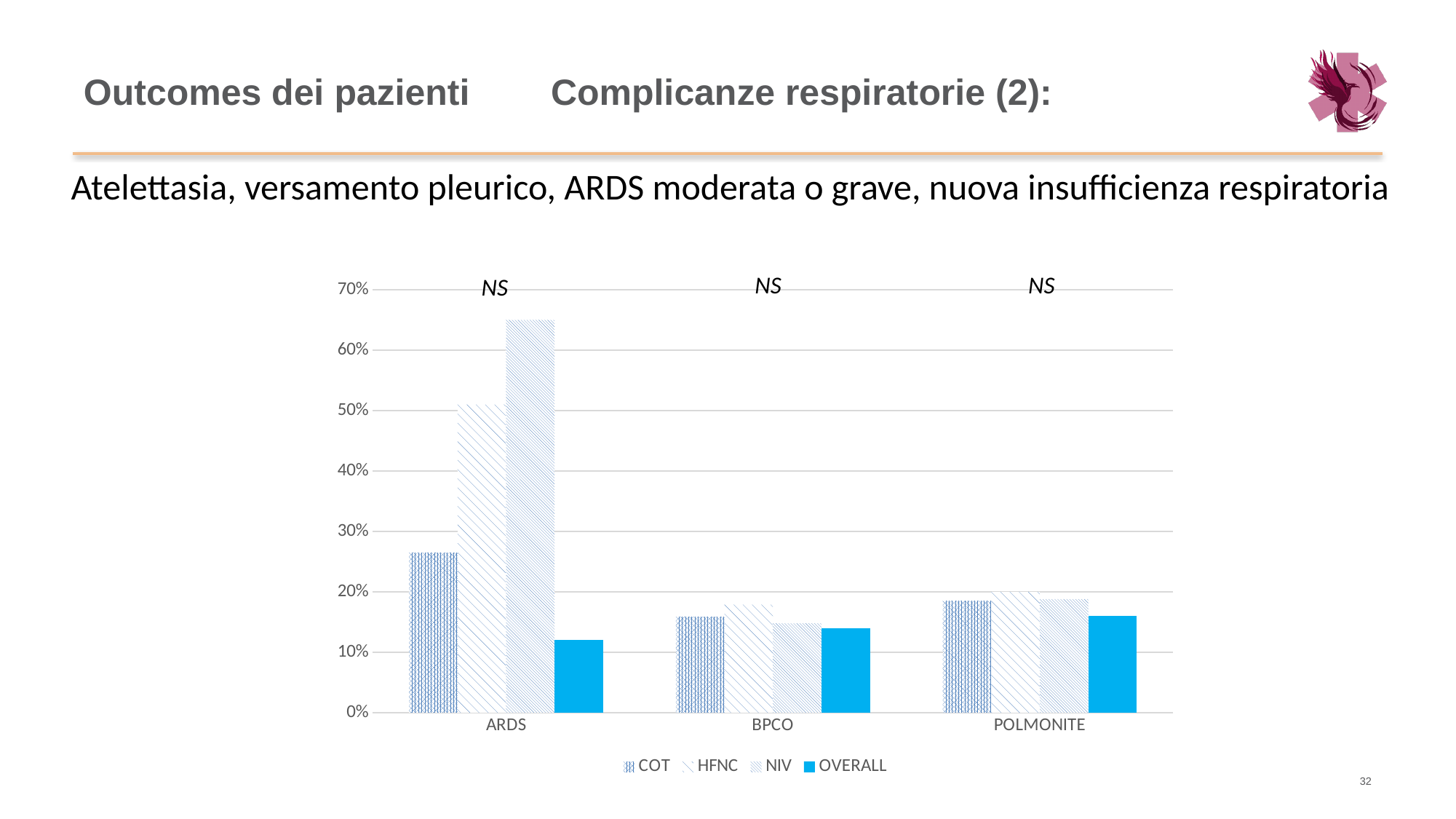
How many categories are shown on the x axis of the chart? 3 Which series has the highest value in the ARDS category? NIV Which category has the highest NIV value? ARDS What kind of chart is shown on the slide? bar chart Is the HFNC value for ARDS greater or less than 40%? greater Is the NIV value for ARDS greater or less than 60%? greater What annotation is printed above each group of bars in the chart? NS Is the OVERALL value for BPCO greater or less than 20%? less How many series does the chart legend list? 4 Which series has the lowest value in the ARDS category? OVERALL In the ARDS category, which is larger: the COT value or the OVERALL value? COT In the ARDS category, which is larger: the NIV value or the HFNC value? NIV